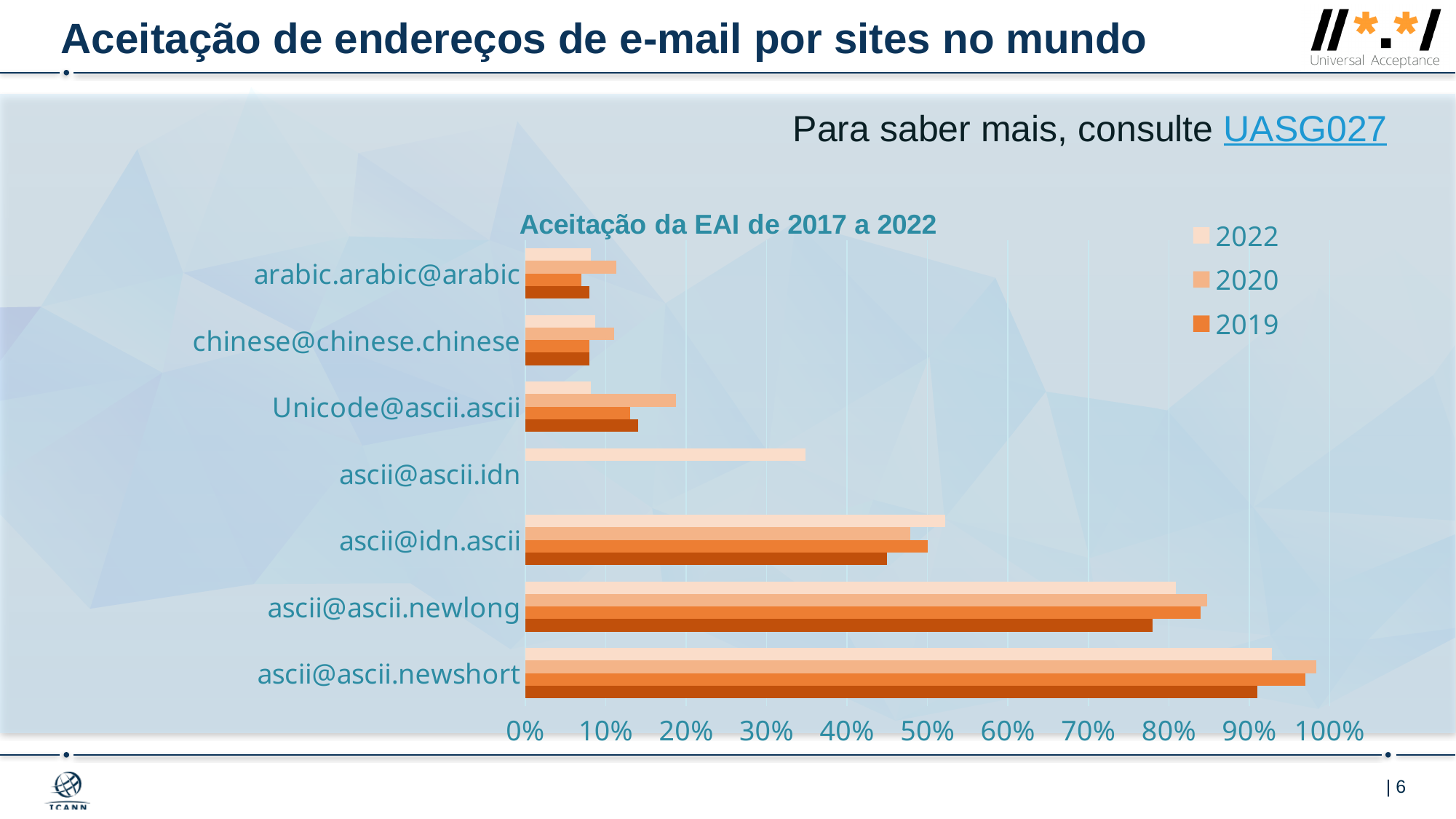
How many series does the chart legend list? 3 Which years are listed in the chart legend? 2022, 2020, 2019 Is the 2020 value for Unicode@ascii.ascii greater or less than 20%? less Which category has the highest value for 2022? ascii@ascii.newshort How many categories (address types) are plotted on the chart? 7 Which category has the lowest value for 2019? arabic.arabic@arabic What kind of chart is shown on the slide? bar chart Is the 2020 value for ascii@ascii.newshort greater or less than 90%? greater What is the title of the chart? Aceitação da EAI de 2017 a 2022 Is the 2022 value for ascii@ascii.idn greater or less than 40%? less